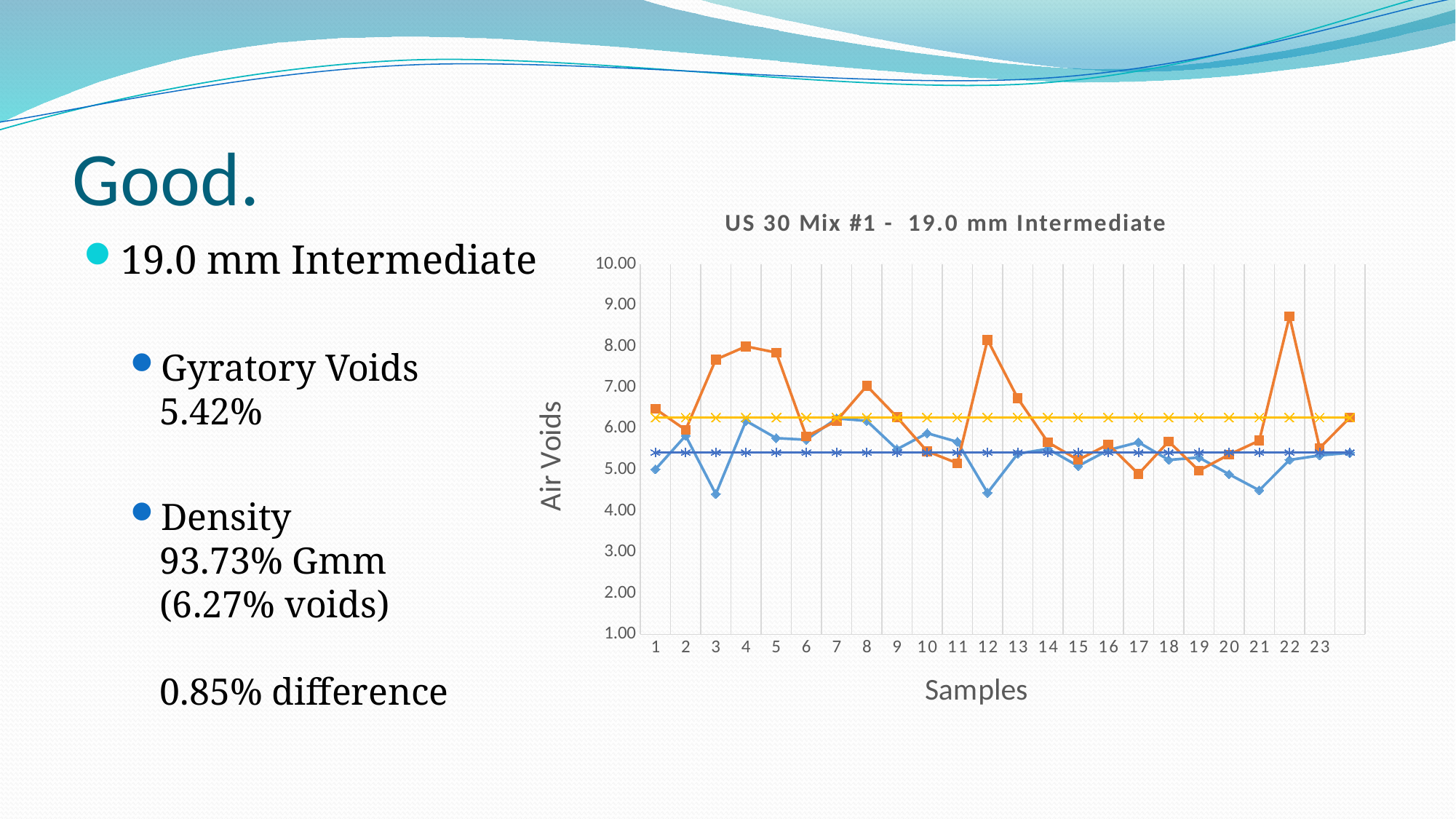
How many sample numbers are labelled on the horizontal axis? 23 What is the lowest tick value shown on the vertical axis? 1.00 What kind of chart is shown on the slide? line chart At which sample does the orange square-marker series reach its highest value? 22 Is the value of the blue diamond-marker series at sample 3 greater or less than 5.00? less What is the title of the chart? US 30 Mix #1 - 19.0 mm Intermediate What is the label of the vertical axis of the chart? Air Voids Is the value of the orange square-marker series at sample 4 greater or less than 7.00? greater What is the highest tick value shown on the vertical axis? 10.00 At sample 3, which series has the larger value: the orange square-marker series or the blue diamond-marker series? the orange square-marker series Is the value of the blue diamond-marker series at sample 12 greater or less than 5.00? less